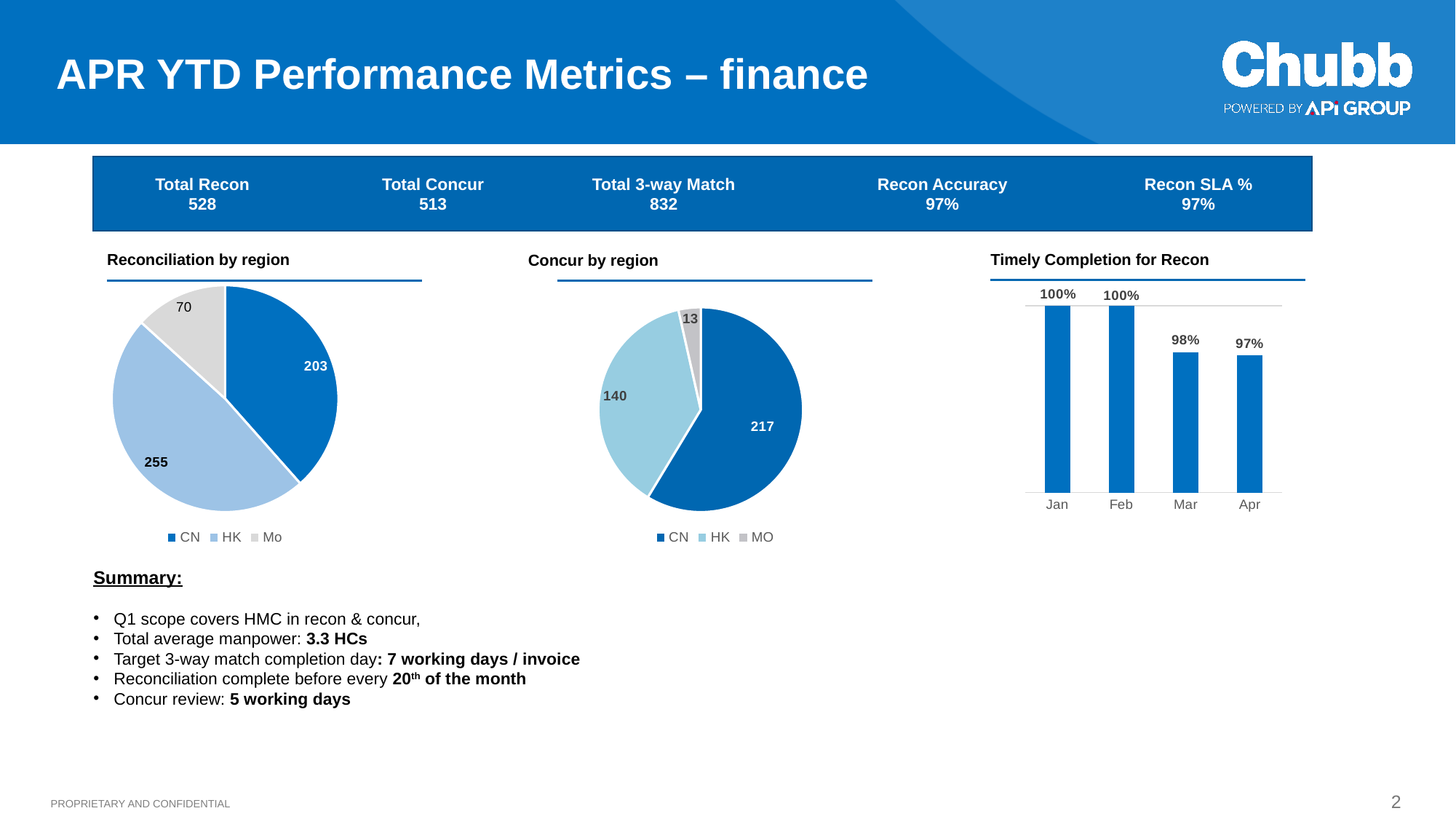
In the Reconciliation by region pie chart, what is the total of all slices? 528 In the Concur by region pie chart, what is the value for MO? 13 How many entries does the legend of the Concur by region chart list? 3 In the Concur by region pie chart, is the value for CN or HK larger? CN In the Reconciliation by region pie chart, which region has the smallest slice? Mo In the Reconciliation by region pie chart, what is the difference between the HK and CN values? 52 What kind of chart is Timely Completion for Recon? bar chart In the Timely Completion for Recon chart, what is the value for Mar? 98% In the Concur by region pie chart, which region has the largest slice? CN In the Reconciliation by region pie chart, what is the value for HK? 255 In the Concur by region pie chart, what is the difference between the CN and HK values? 77 In the Timely Completion for Recon chart, do the values rise or fall from Jan to Apr? fall